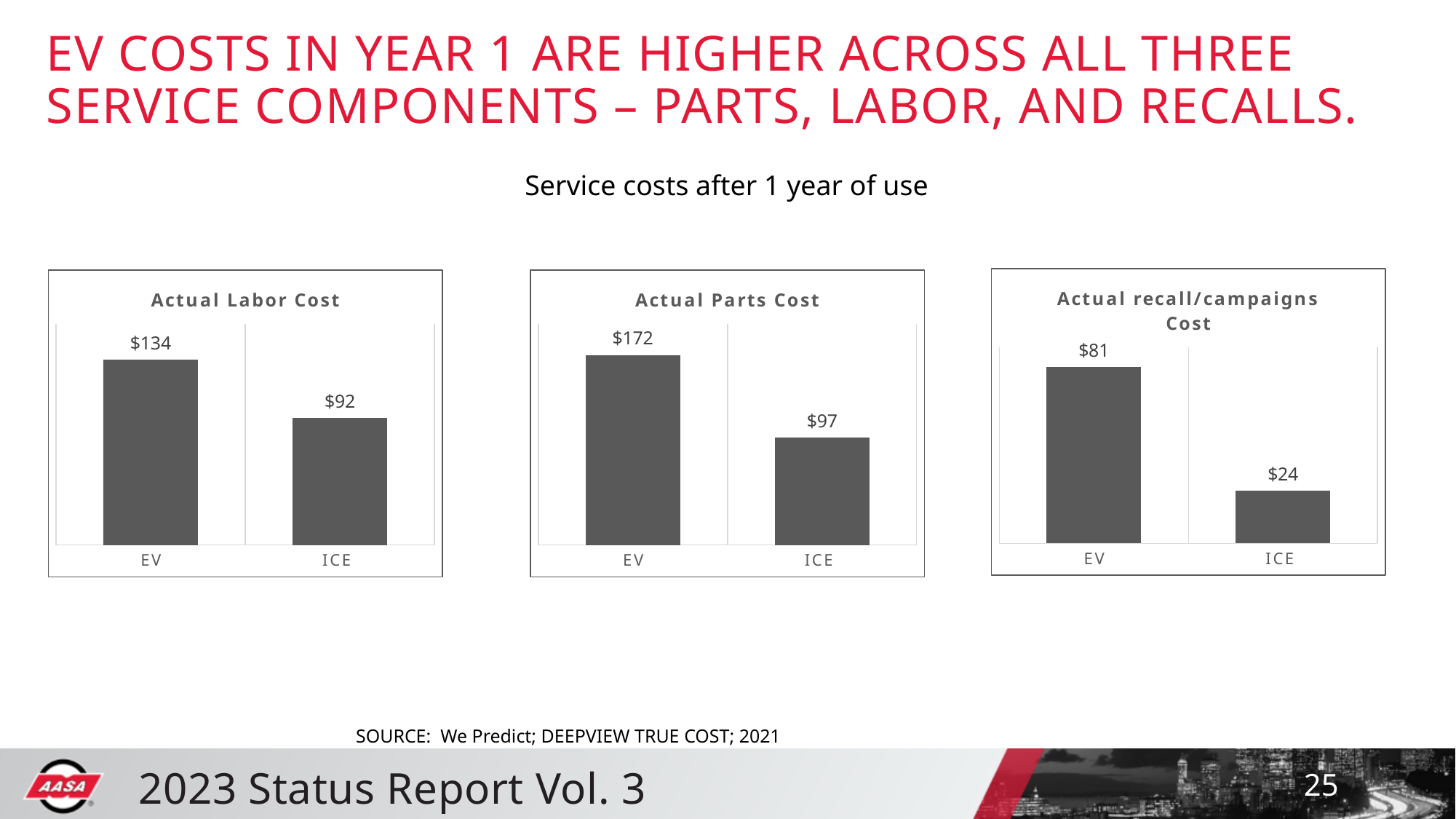
In the Actual Parts Cost chart, what is the value for EV? $172 How many categories does the Actual Labor Cost chart show? 2 What kind of chart is the Actual Parts Cost chart? Bar chart In the Actual recall/campaigns Cost chart, which is larger, EV or ICE? EV In the Actual Labor Cost chart, what is the value for ICE? $92 In the Actual Parts Cost chart, what is the value for ICE? $97 In the Actual Labor Cost chart, what is the difference between the EV and ICE values? $42 In the Actual Parts Cost chart, what is the difference between the EV and ICE values? $75 In the Actual recall/campaigns Cost chart, which category has the highest value? EV In the Actual Parts Cost chart, which category has the lowest value? ICE In the Actual recall/campaigns Cost chart, what is the value for ICE? $24 In the Actual Labor Cost chart, what is the value for EV? $134